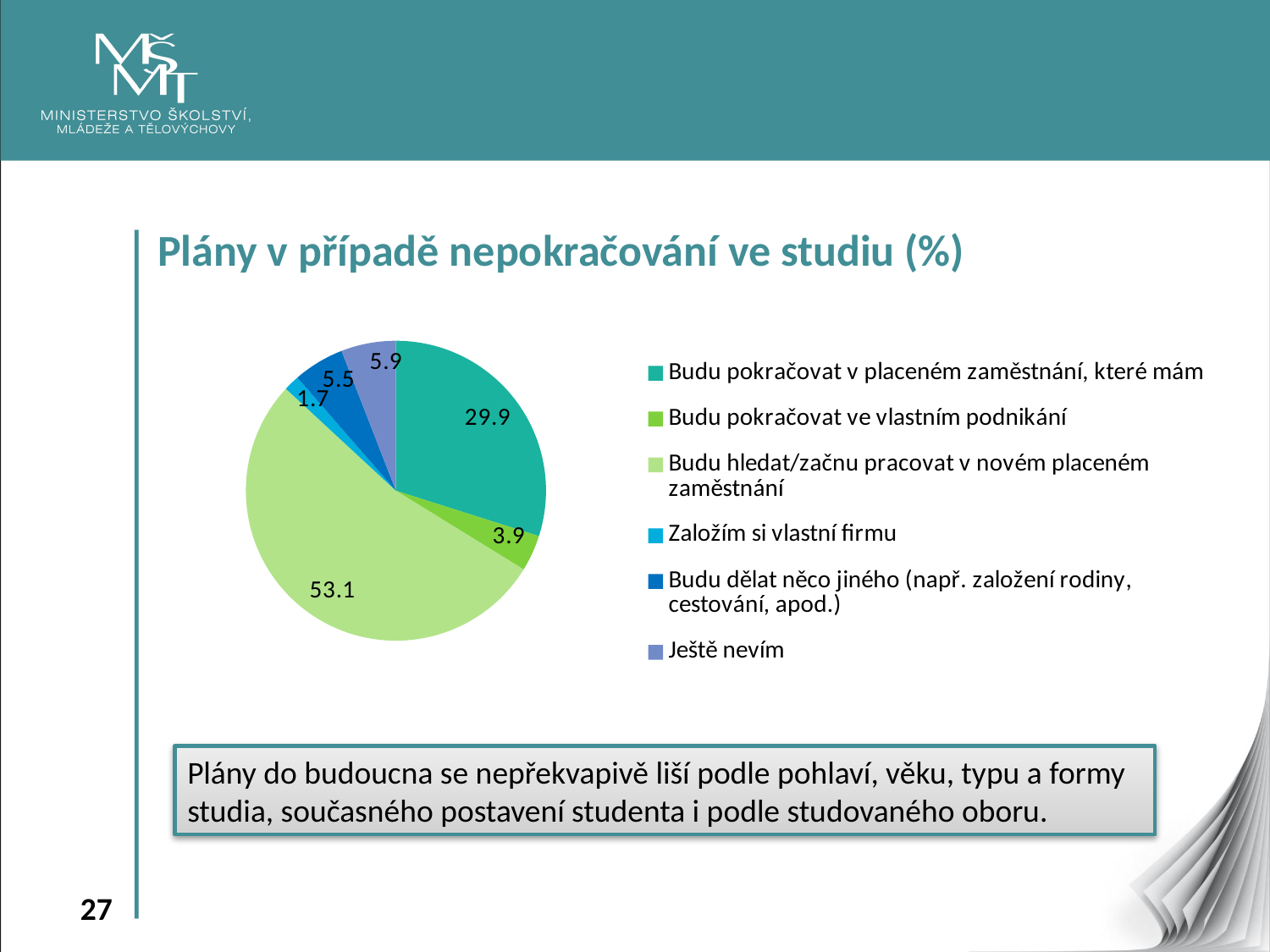
What is the value for "Založím si vlastní firmu"? 1.7 Which is larger: the value for "Ještě nevím" or the value for "Budu pokračovat ve vlastním podnikání"? Ještě nevím What type of chart is shown on the slide? pie chart What is the value for "Budu pokračovat ve vlastním podnikání"? 3.9 What is the value for "Budu hledat/začnu pracovat v novém placeném zaměstnání"? 53.1 What is the value for "Budu pokračovat v placeném zaměstnání, které mám"? 29.9 What is the title of the chart? Plány v případě nepokračování ve studiu (%) What is the difference between the values for "Budu hledat/začnu pracovat v novém placeném zaměstnání" and "Budu pokračovat v placeném zaměstnání, které mám"? 23.2 How many categories does the legend list? 6 What is the value for "Ještě nevím"? 5.9 Which category has the smallest slice of the pie? Založím si vlastní firmu Which category has the largest slice of the pie? Budu hledat/začnu pracovat v novém placeném zaměstnání